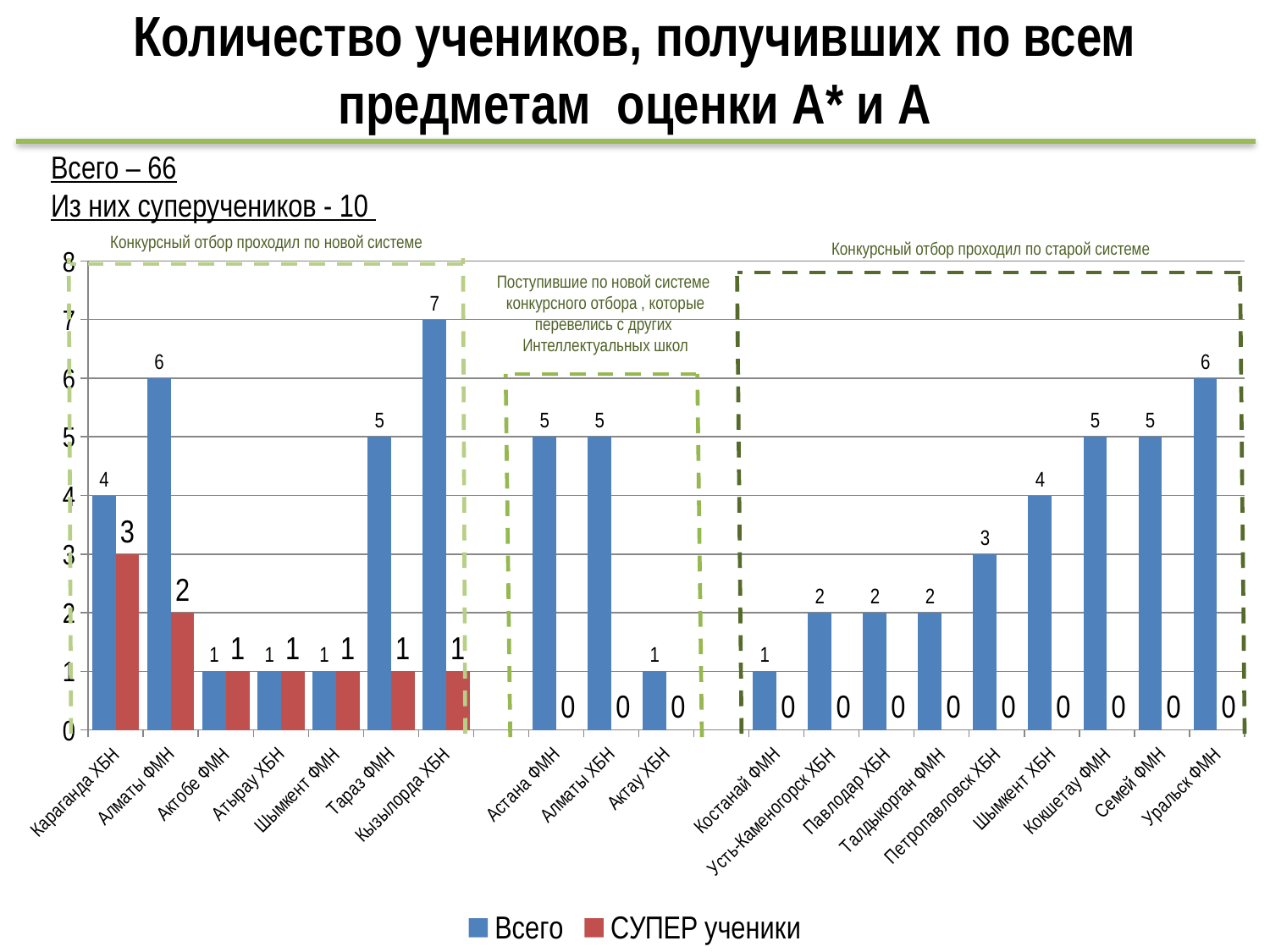
What is the value of the Всего series for Уральск ФМН? 6 Which is larger: the Всего value for Алматы ФМН or for Шымкент ХБН? Алматы ФМН Which colour represents the СУПЕР ученики series in the chart? Red What is the difference between the Всего values for Кызылорда ХБН and Петропавловск ХБН? 4 What kind of chart is shown on the slide? Bar chart What is the value of the СУПЕР ученики series for Караганда ХБН? 3 How many categories are shown on the x axis of the chart? 19 What is the value of the Всего series for Кызылорда ХБН? 7 How many series does the legend list? 2 Which category has the highest value in the СУПЕР ученики series? Караганда ХБН Which category has the highest value in the Всего series? Кызылорда ХБН What is the value of the СУПЕР ученики series for Алматы ФМН? 2